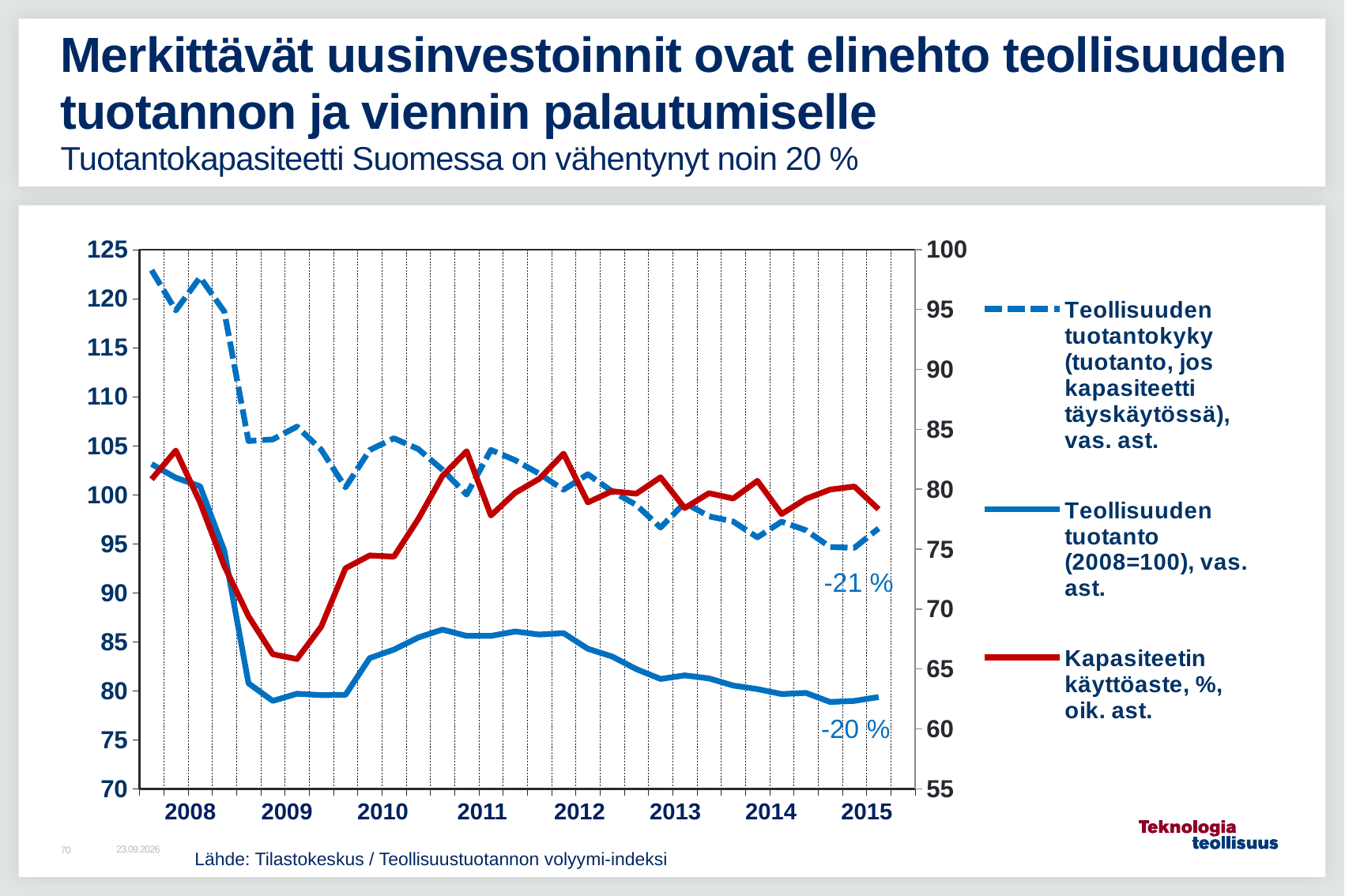
Is the value of Teollisuuden tuotanto (2008=100) in 2015 greater or less than 85? less Does Teollisuuden tuotanto (2008=100) rise or fall between 2008 and 2015? fall Is the lowest value of Kapasiteetin käyttöaste in 2009 greater or less than 70 on the right axis? less In which year does Kapasiteetin käyttöaste reach its lowest point? 2009 At the start of 2008, which is higher: Teollisuuden tuotantokyky or Teollisuuden tuotanto (2008=100)? Teollisuuden tuotantokyky What kind of chart is shown on the slide? line chart What percentage change is annotated on the chart for Teollisuuden tuotanto (2008=100)? -20 % What percentage change is annotated on the chart for Teollisuuden tuotantokyky? -21 % Is the value of Teollisuuden tuotantokyky in 2015 greater or less than 100? less How many year labels are shown on the x axis? 8 How many series does the legend list? 3